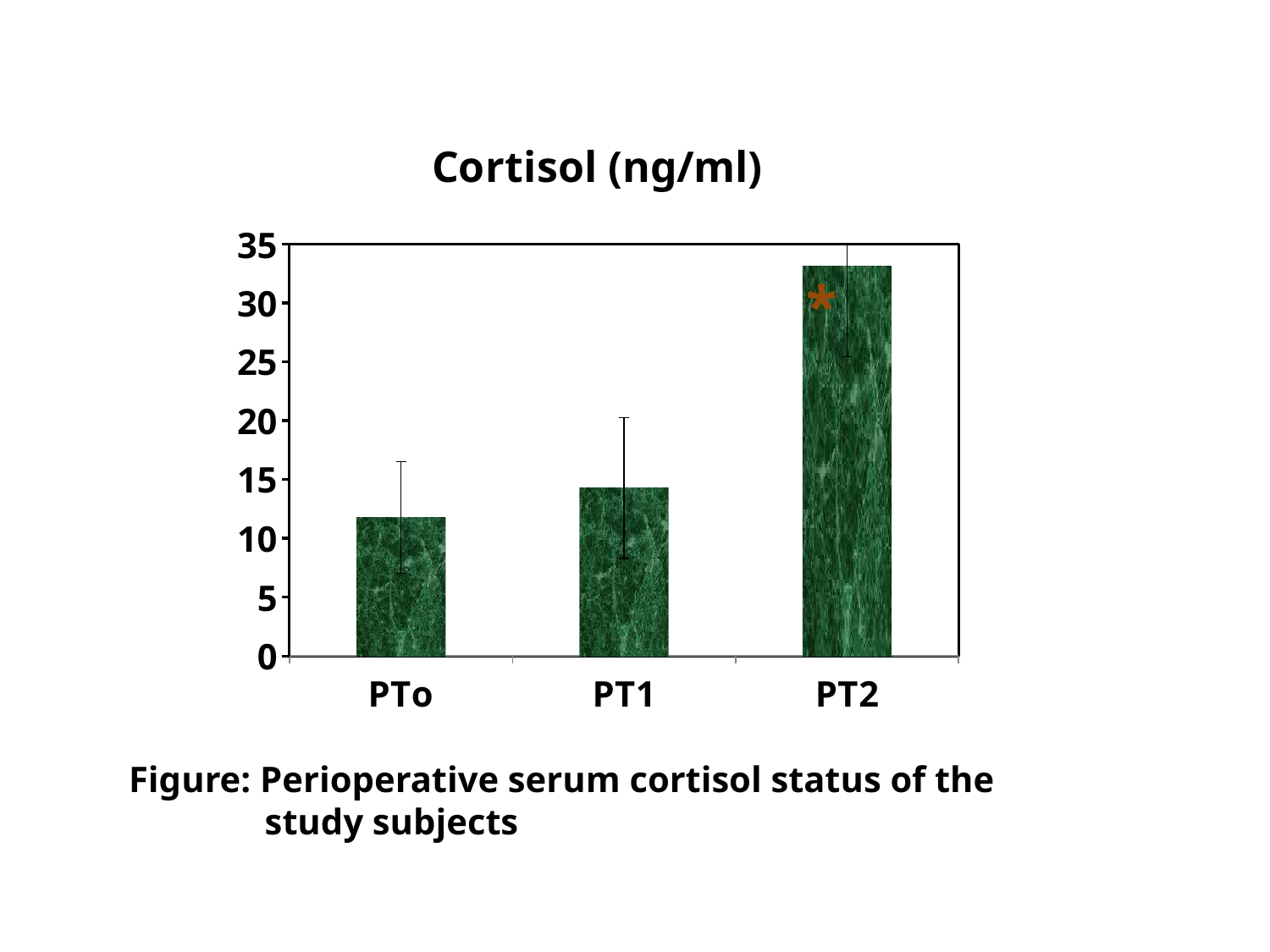
Which bar is marked with an asterisk? PT2 How many categories are plotted on the x axis? 3 Which category has the lowest cortisol value? PTo What is the title of the chart? Cortisol (ng/ml) Is the value for PTo greater or less than 15? less Is the value for PT1 greater or less than 10? greater Is the value for PT2 greater or less than 30? greater Do the cortisol values rise or fall from PTo to PT2? rise Which category has the highest cortisol value? PT2 What kind of chart is shown on the slide? bar chart Which is larger, the value for PTo or the value for PT1? PT1 Which is larger, the value for PT1 or the value for PT2? PT2